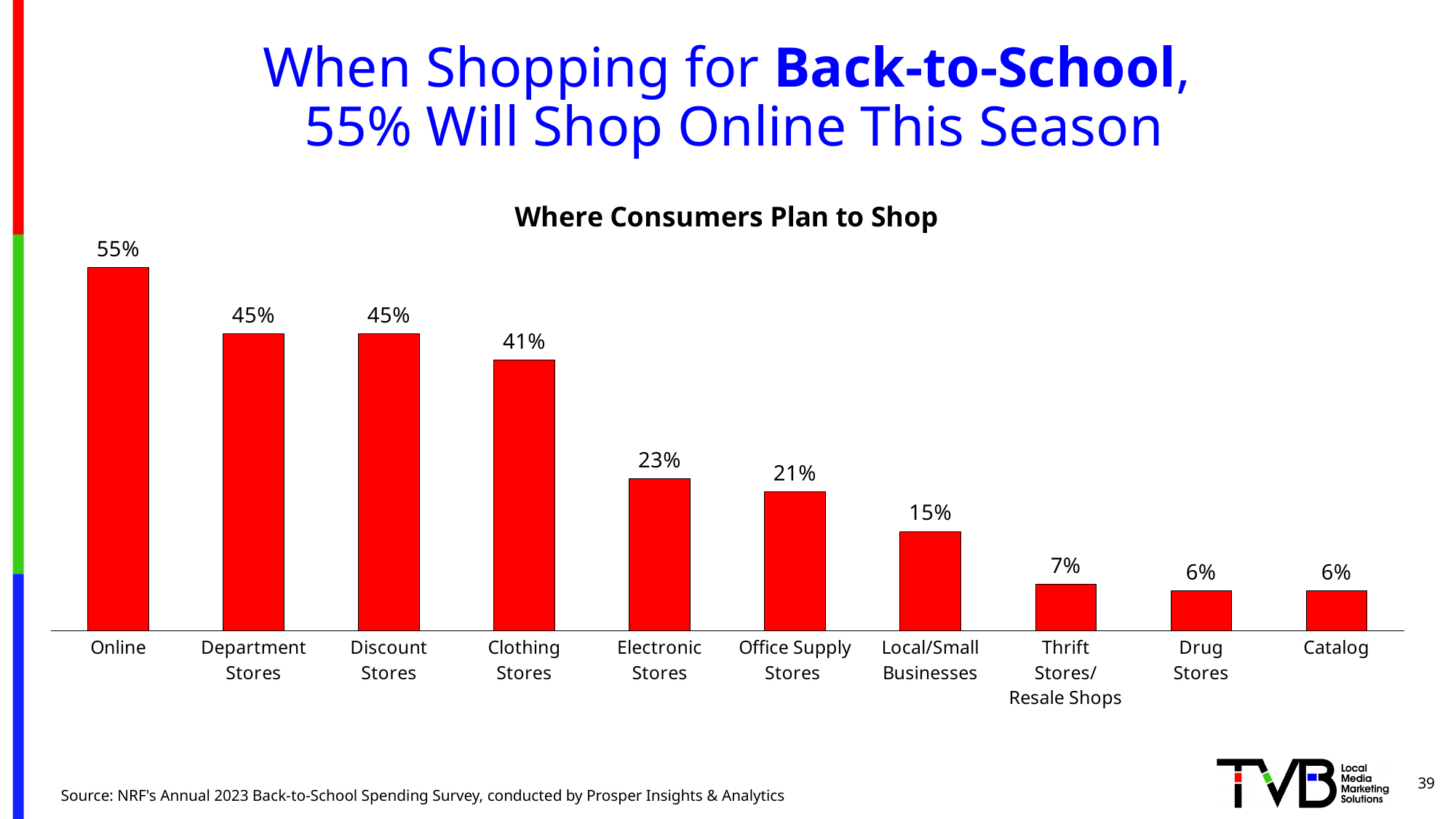
What is the difference between the values for Thrift Stores/Resale Shops and Drug Stores? 1 percentage point What colour are the bars in the chart? Red What kind of chart is shown on the slide? Bar chart What is the value for Electronic Stores? 23% What percentage of consumers plan to shop at Clothing Stores? 41% What is the title of the chart? Where Consumers Plan to Shop Which is larger, the value for Department Stores or the value for Electronic Stores? Department Stores What is the difference between the values for Online and Office Supply Stores? 34 percentage points Do the values rise or fall from left to right across the categories? Fall Which category has the highest value? Online What percentage of consumers plan to shop at Local/Small Businesses? 15% How many categories are shown in the chart? 10